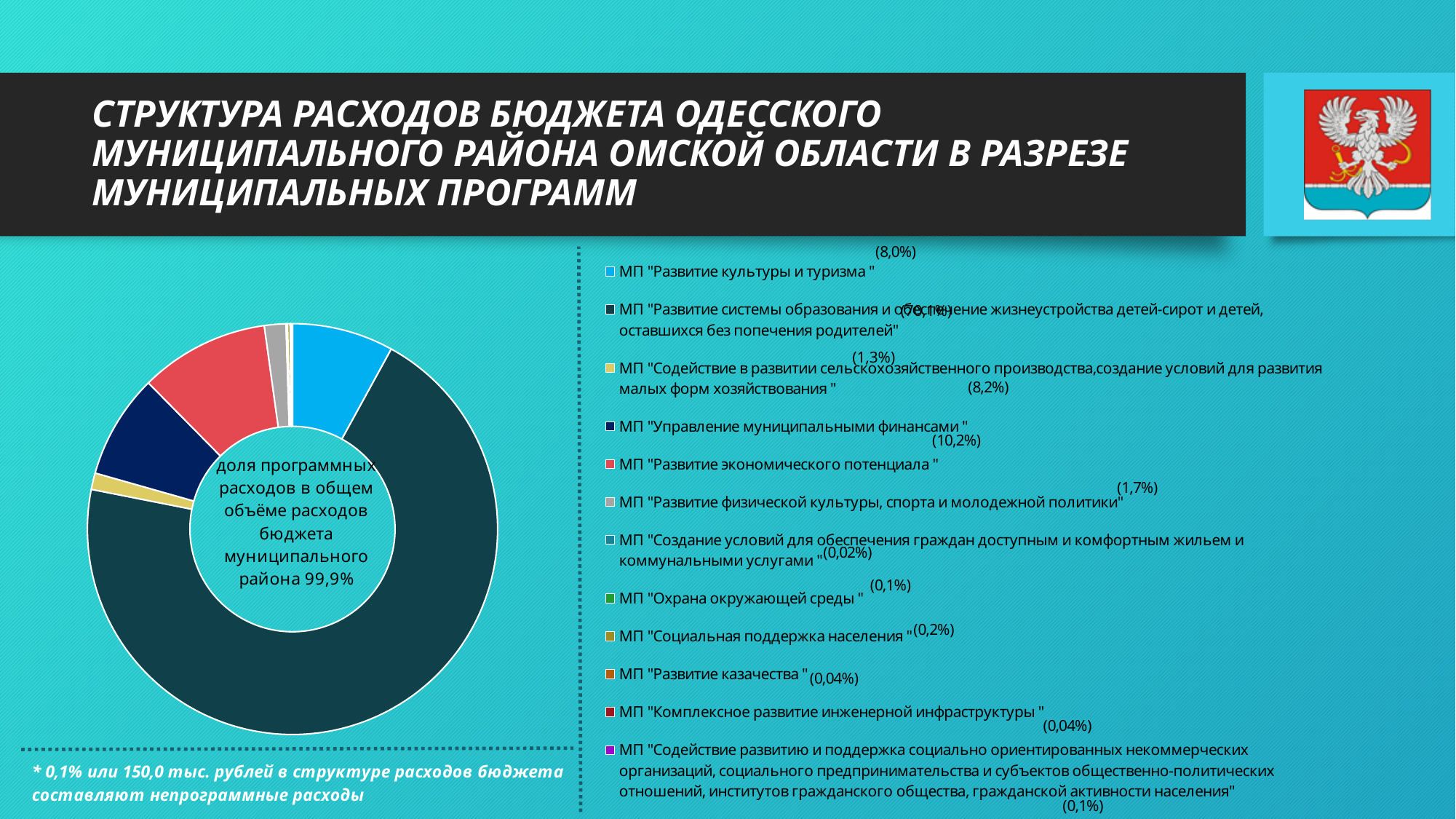
Is the share of МП "Развитие системы образования..." greater or less than 50%? greater According to the text in the centre of the chart, what is the share of programme expenditure in the total budget expenditure of the municipal district? 99,9% Which municipal programme has the largest share of budget expenditure in the chart? МП "Развитие системы образования и обеспечение жизнеустройства детей-сирот и детей, оставшихся без попечения родителей" What kind of chart is shown on the slide? pie chart (doughnut) Which slice is larger: МП "Развитие экономического потенциала" or МП "Содействие в развитии сельскохозяйственного производства..."? МП "Развитие экономического потенциала" According to the footnote, what share of budget expenditure is non-programme expenditure? 0,1% (150,0 тыс. рублей) What colour is the slice for МП "Развитие экономического потенциала" in the chart? red Is the share of МП "Развитие культуры и туризма" greater or less than 25%? less Which slice is larger: МП "Развитие системы образования..." or МП "Развитие культуры и туризма"? МП "Развитие системы образования..." How many municipal programmes (МП) are listed in the chart legend? 12